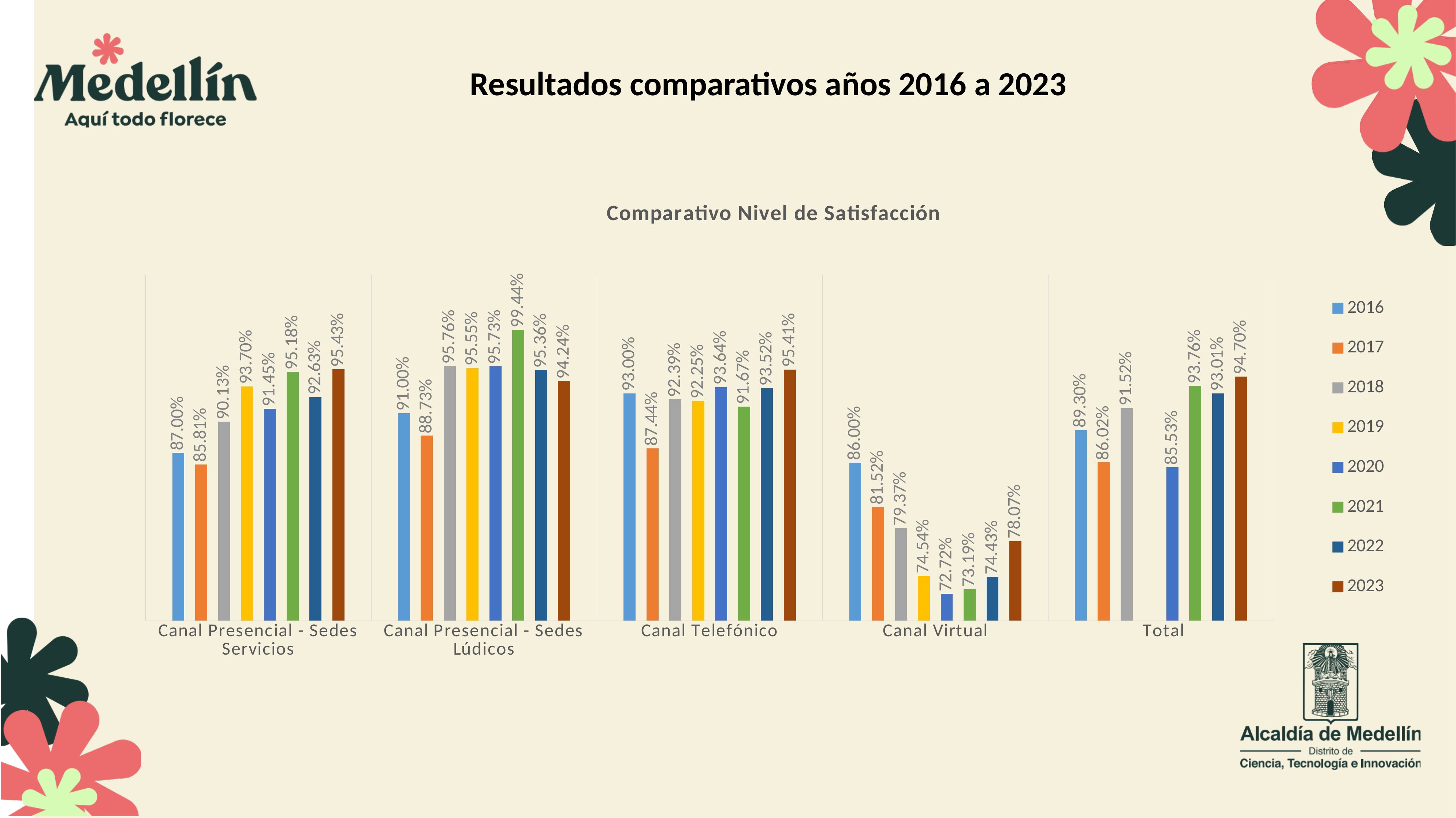
What is the title of the chart? Comparativo Nivel de Satisfacción What kind of chart is shown on the slide? Bar chart What is the value for 2021 in the Canal Presencial - Sedes Lúdicos category? 99.44% How many series does the legend list? 8 Which year has the highest value in the Canal Presencial - Sedes Servicios category? 2023 How many categories are shown on the x axis? 5 What is the value for 2023 in the Total category? 94.70% What is the value for 2023 in the Canal Virtual category? 78.07% What is the value for 2016 in the Canal Telefónico category? 93.00% Which year has the lowest value in the Canal Virtual category? 2020 What is the difference between the 2023 and 2016 values in the Canal Presencial - Sedes Servicios category? 8.43% In the Canal Telefónico category, which is larger: the value for 2017 or the value for 2021? 2021